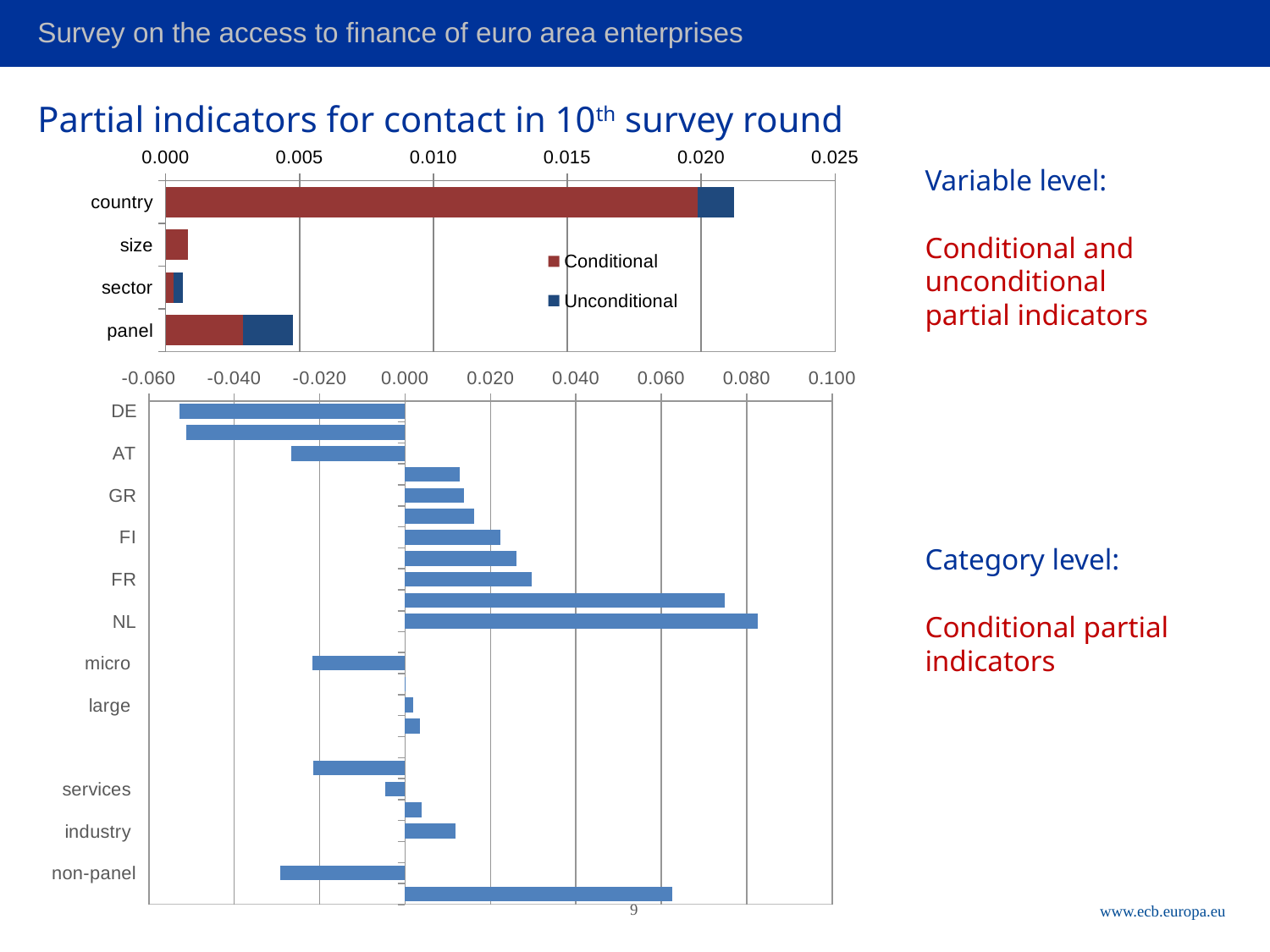
In the top chart, is the total stacked value for country greater or less than 0.015? greater In the top chart, is the total stacked value for panel greater or less than 0.010? less In the top chart, which category has the longest stacked bar? country What kind of chart is the top chart on the slide? bar chart How many series does the legend of the top chart list? 2 In the bottom chart, is the value of the bar at NL greater or less than 0.060? greater What are the two series named in the legend of the top chart? Conditional and Unconditional In the top chart, which colour represents the Conditional series? red How many categories are shown on the vertical axis of the top chart? 4 What kind of chart is the bottom chart on the slide? bar chart In the top chart, which stacked bar is longer, size or panel? panel